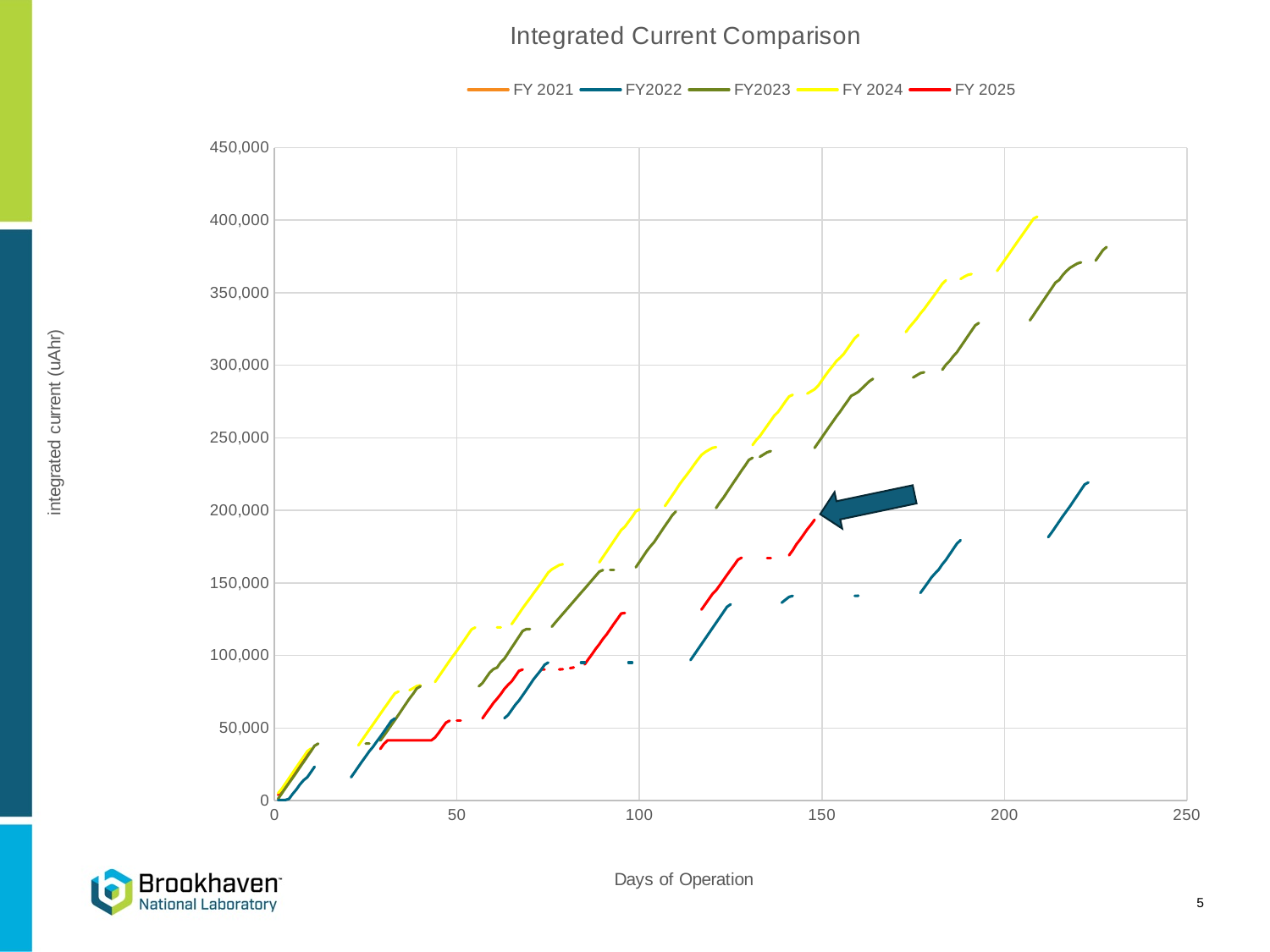
Is the value of the FY 2024 series at 150 days of operation greater or less than 250,000? greater Is the final value of the FY2022 series greater or less than 200,000? greater What kind of chart is shown on the slide? Line chart What is the label of the y axis? integrated current (uAhr) How many series does the legend list? 5 What is the title of the chart? Integrated Current Comparison Which series reaches the highest integrated current on the chart? FY 2024 At 100 days of operation, which series has the larger integrated current, FY 2024 or FY2022? FY 2024 At 150 days of operation, which series has the larger integrated current, FY 2024 or FY 2025? FY 2024 Is the final value of the FY 2025 series greater or less than 150,000? greater Do the integrated current values rise or fall as days of operation increase? Rise